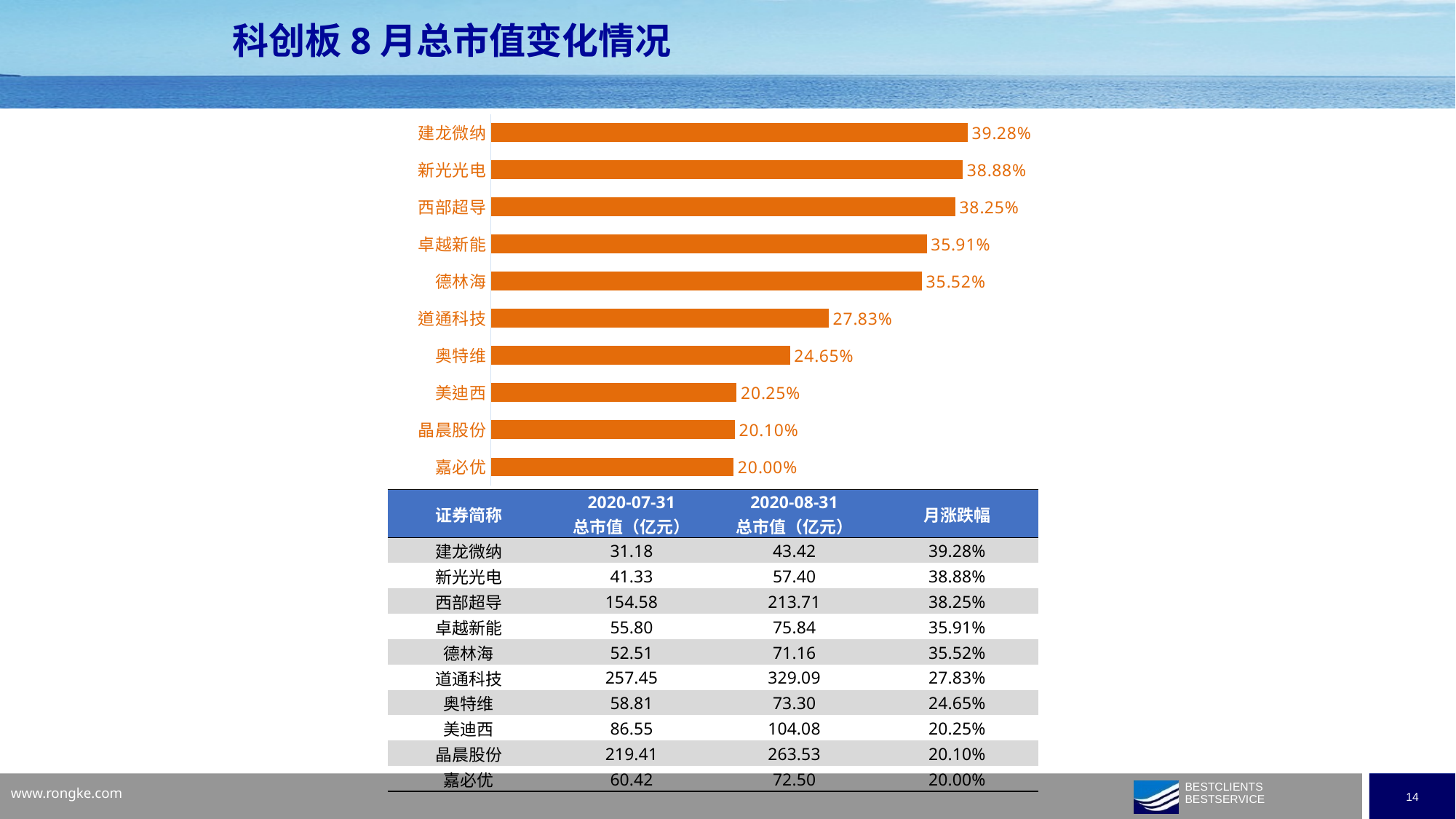
What is the difference between the values for 建龙微纳 and 嘉必优 in the bar chart? 19.28% What kind of chart is shown on the slide? Bar chart Which category has the highest value in the bar chart? 建龙微纳 What is the value shown for 嘉必优 in the bar chart? 20.00% Which has a larger value in the bar chart, 卓越新能 or 美迪西? 卓越新能 Do the values in the bar chart rise or fall from the top category to the bottom category? Fall What is the difference between the values for 道通科技 and 奥特维 in the bar chart? 3.18% What is the value shown for 建龙微纳 in the bar chart? 39.28% Which category has the lowest value in the bar chart? 嘉必优 How many categories are shown in the bar chart? 10 What colour are the bars in the chart? Orange What is the value shown for 道通科技 in the bar chart? 27.83%